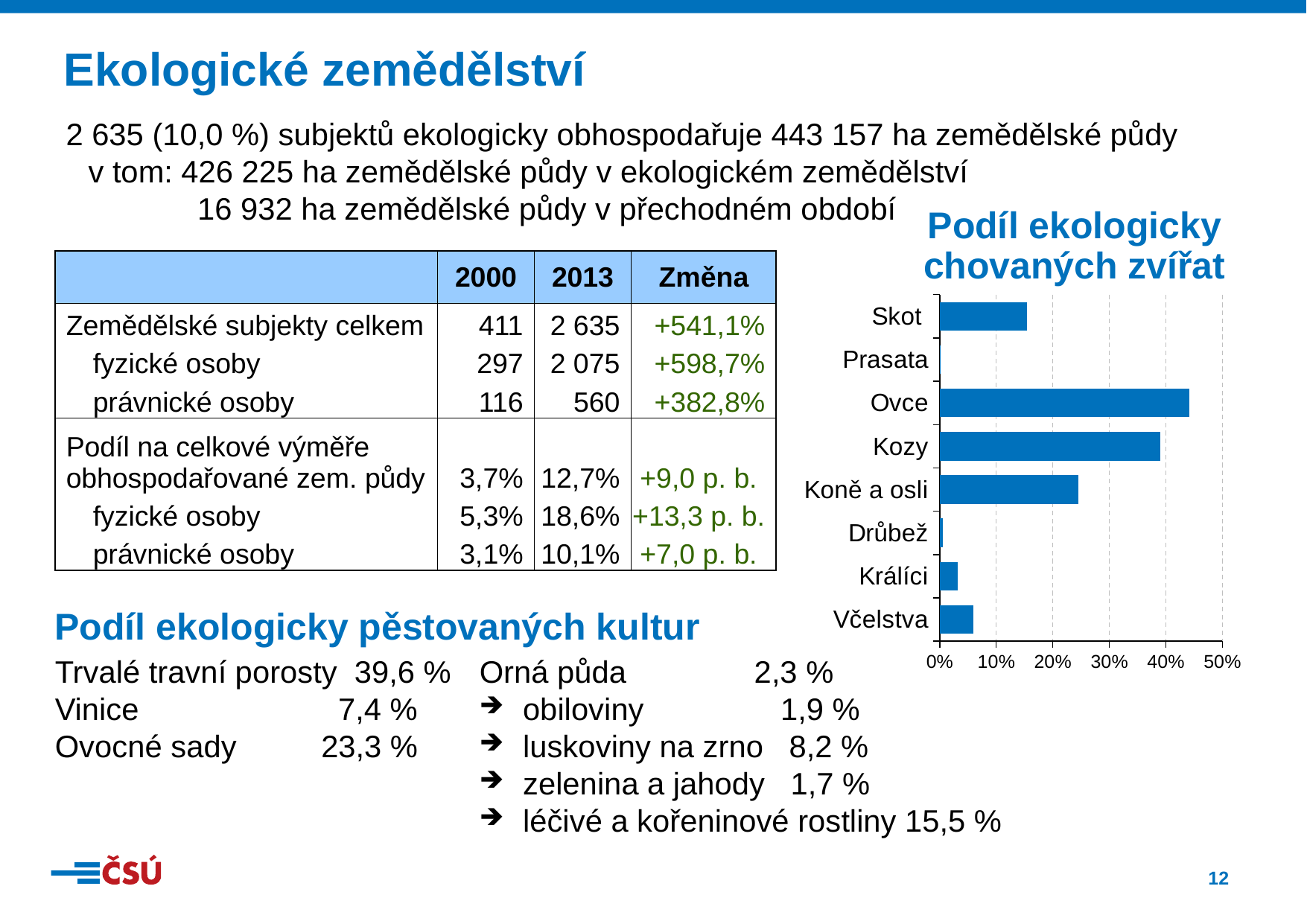
In the "Podíl ekologicky chovaných zvířat" chart, is the value for Ovce greater or less than 40%? greater In the "Podíl ekologicky chovaných zvířat" chart, is the value for Kozy greater or less than 30%? greater In the "Podíl ekologicky chovaných zvířat" chart, is the value for Skot greater or less than 20%? less How many animal categories are plotted in the "Podíl ekologicky chovaných zvířat" chart? 8 What is the highest value shown on the horizontal axis of the "Podíl ekologicky chovaných zvířat" chart? 50% What kind of chart is shown under the title "Podíl ekologicky chovaných zvířat"? bar chart In the "Podíl ekologicky chovaných zvířat" chart, which is larger, the value for Ovce or the value for Kozy? Ovce In the "Podíl ekologicky chovaných zvířat" chart, which is larger, the value for Skot or the value for Koně a osli? Koně a osli In the "Podíl ekologicky chovaných zvířat" chart, which category has the highest share? Ovce